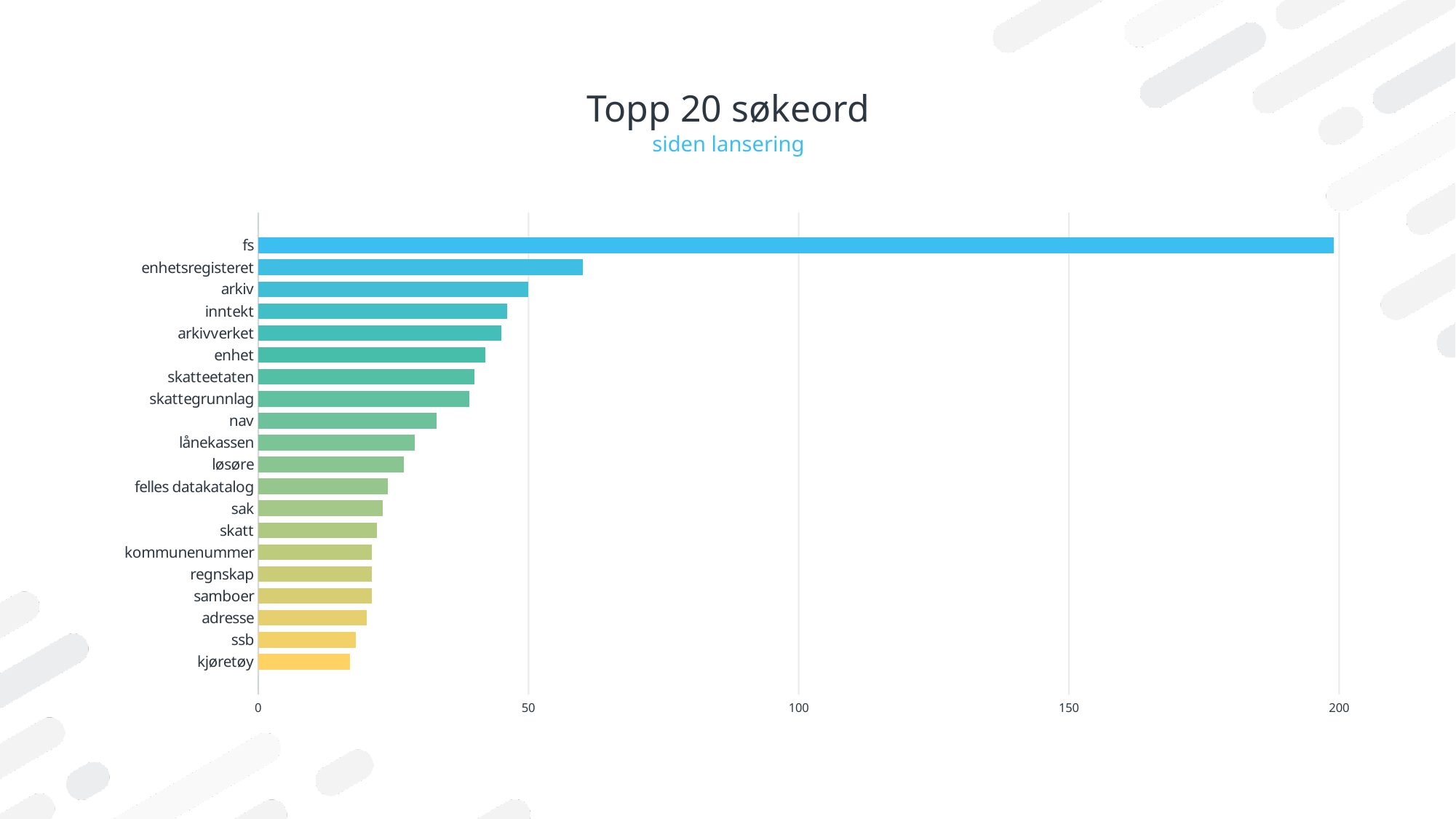
Which has a larger value, arkiv or nav? arkiv Which has a larger value, fs or enhetsregisteret? fs Do the bar values increase or decrease going from the top of the chart (fs) to the bottom (kjøretøy)? decrease Is the value for fs greater or less than 150? greater Which search term has the highest value? fs Is the value for nav greater or less than 50? less Is the value for inntekt greater or less than 50? less What is the title of the chart? Topp 20 søkeord What subtitle appears under the chart title? siden lansering How many search terms (categories) are plotted in the chart? 20 What kind of chart is shown on the slide? bar chart